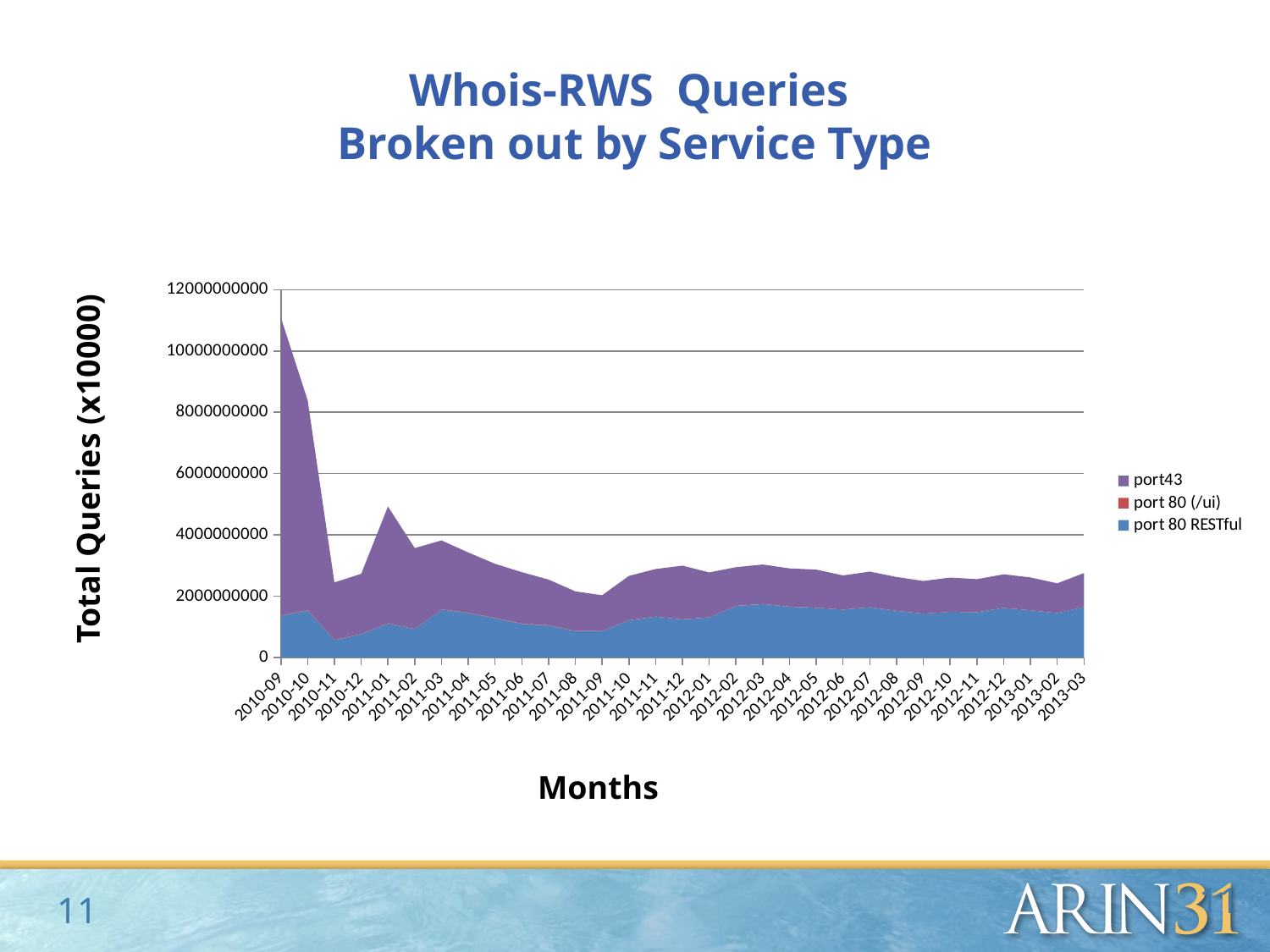
What kind of chart is shown on the slide? stacked area chart Is the total value for 2011-01 greater or less than 4000000000? greater How many series does the legend list? 3 Is the total value for 2010-09 larger or smaller than the total value for 2011-01? larger How many months are plotted along the x axis? 31 What is the title of the chart? Whois-RWS Queries Broken out by Service Type Is the total value for 2010-11 greater or less than 4000000000? less Do total queries rise or fall between 2010-09 and 2010-11? fall Which series are listed in the legend? port43, port 80 (/ui), port 80 RESTful Is the port 80 RESTful value for 2010-11 greater or less than 1000000000? less In which month is the total number of queries highest? 2010-09